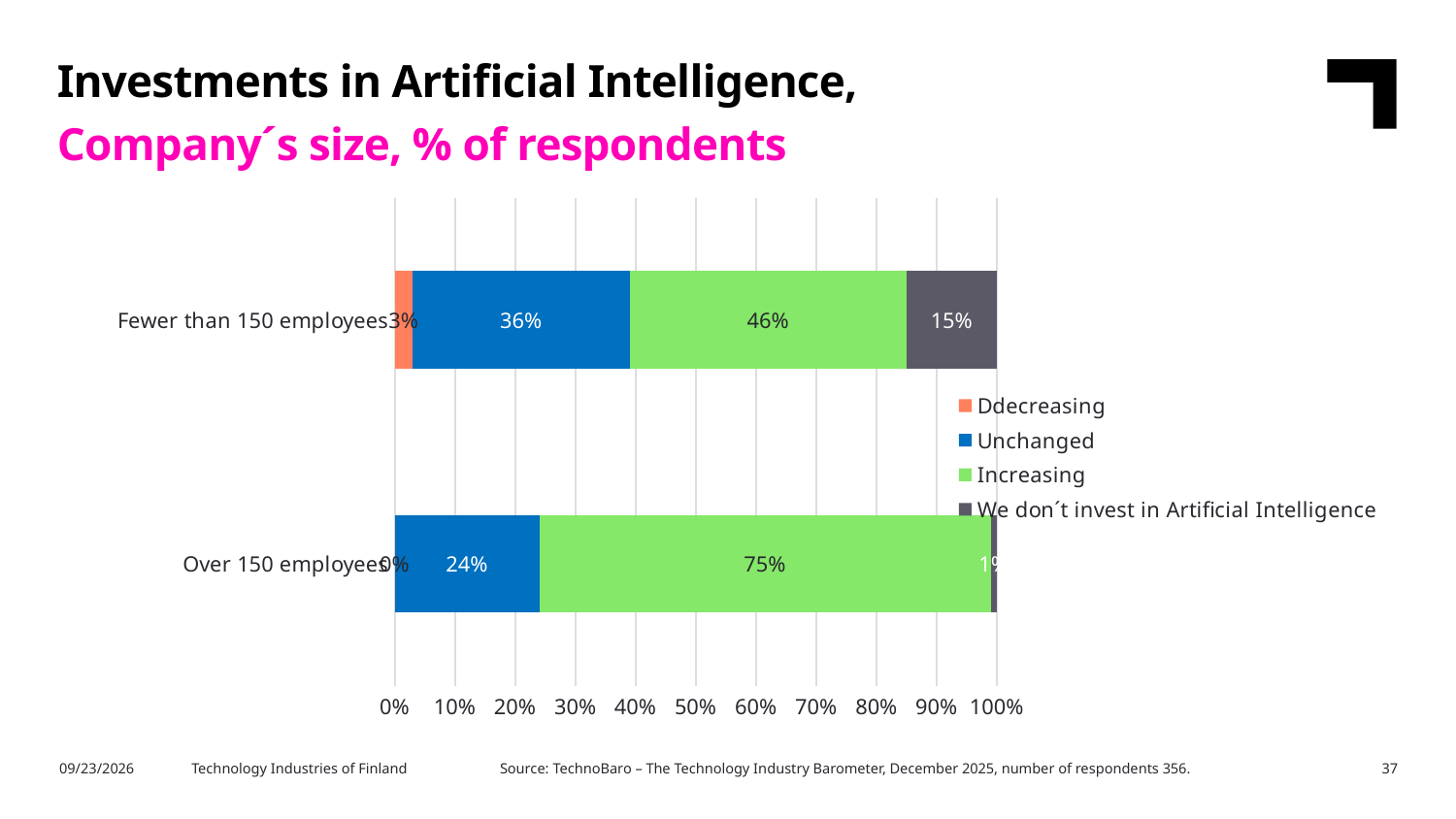
What is the Unchanged value for companies with over 150 employees? 24% What is the Unchanged value for companies with fewer than 150 employees? 36% Which legend entry is shown in orange? Ddecreasing What is the difference between the Unchanged values for fewer than 150 employees and over 150 employees? 12 percentage points What is the difference between the Increasing values for over 150 employees and fewer than 150 employees? 29 percentage points How many series does the legend list? 4 Which company-size category has the higher Increasing value? Over 150 employees What is the Increasing value for companies with over 150 employees? 75% What type of chart is shown on the slide? stacked bar chart What is the Increasing value for companies with fewer than 150 employees? 46% How many company-size categories are plotted? 2 What share of respondents with fewer than 150 employees say they don't invest in Artificial Intelligence? 15%